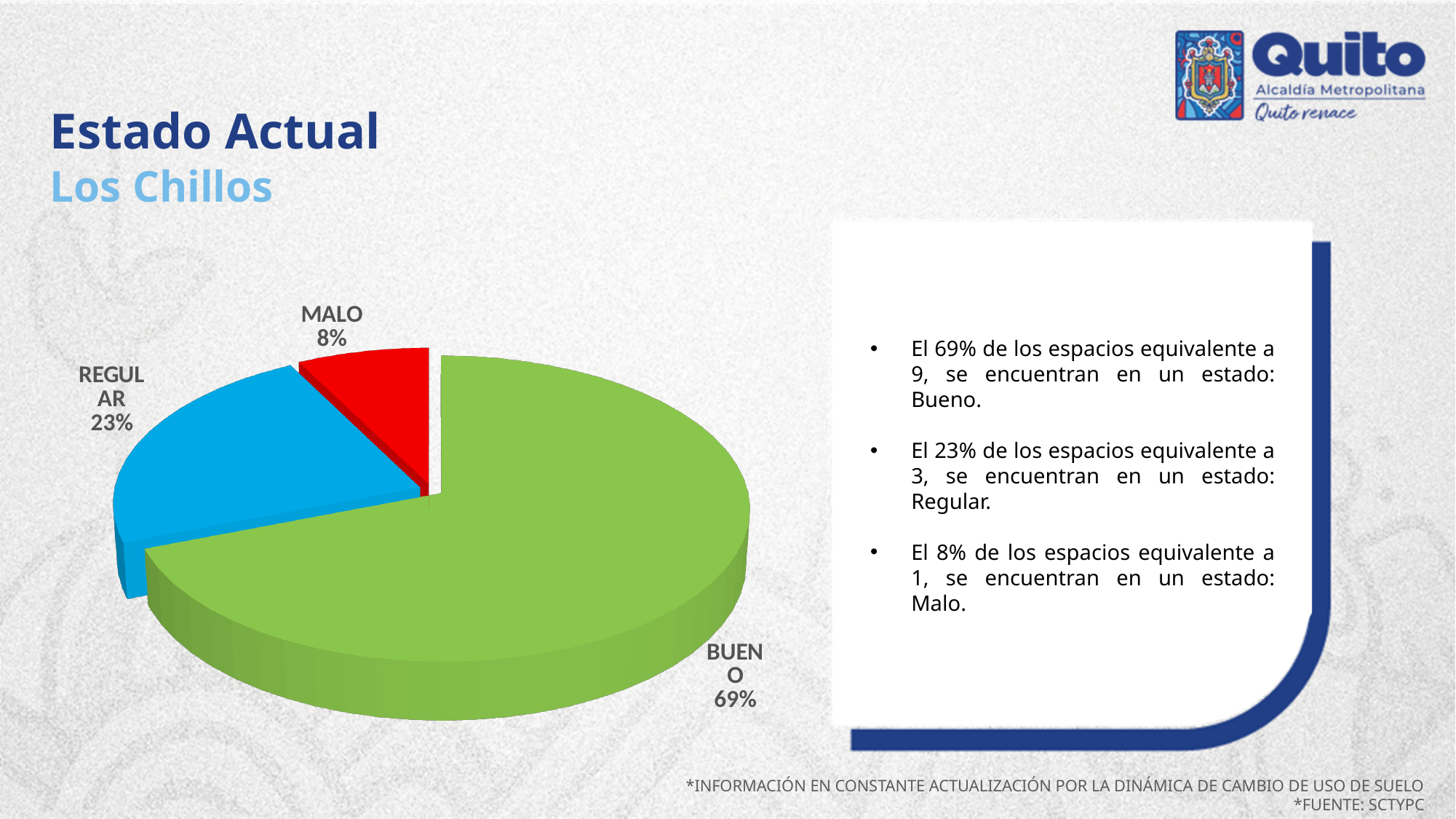
Which category has the largest slice of the pie chart? BUENO What colour is the BUENO slice of the pie chart? Green What percentage of the pie chart is labelled BUENO? 69% What kind of chart is shown on the slide? Pie chart Which slice is larger, REGULAR or MALO? REGULAR Which category has the smallest slice of the pie chart? MALO What is the difference in percentage points between the BUENO and REGULAR slices? 46 What percentage of the pie chart is labelled REGULAR? 23% What colour is the MALO slice of the pie chart? Red What is the difference in percentage points between the REGULAR and MALO slices? 15 What percentage of the pie chart is labelled MALO? 8% How many slices does the pie chart have? 3